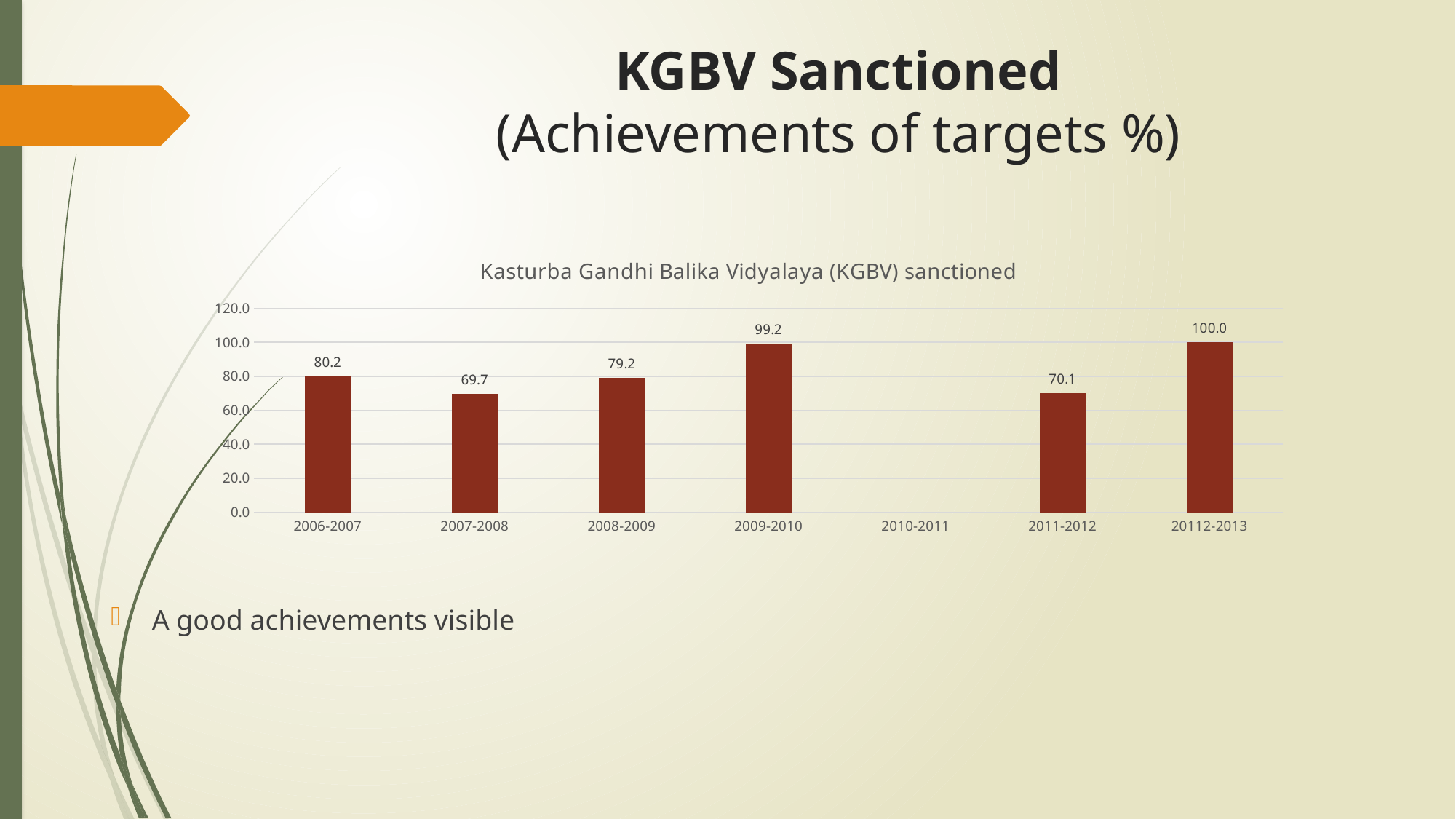
What is the value for 2006-2007? 80.2 Which is larger, the value for 2008-2009 or the value for 2011-2012? 2008-2009 What is the value for 2009-2010? 99.2 What is the title of the chart? Kasturba Gandhi Balika Vidyalaya (KGBV) sanctioned Is the value for 2009-2010 greater or less than 80.0? greater How many bars are plotted on the chart? 6 What is the difference between the values for 2009-2010 and 2007-2008? 29.5 Which category with a plotted bar has the lowest value? 2007-2008 Which category has the highest value? 20112-2013 What kind of chart is shown? bar chart What is the value for 2011-2012? 70.1 What is the difference between the values for 20112-2013 and 2006-2007? 19.8